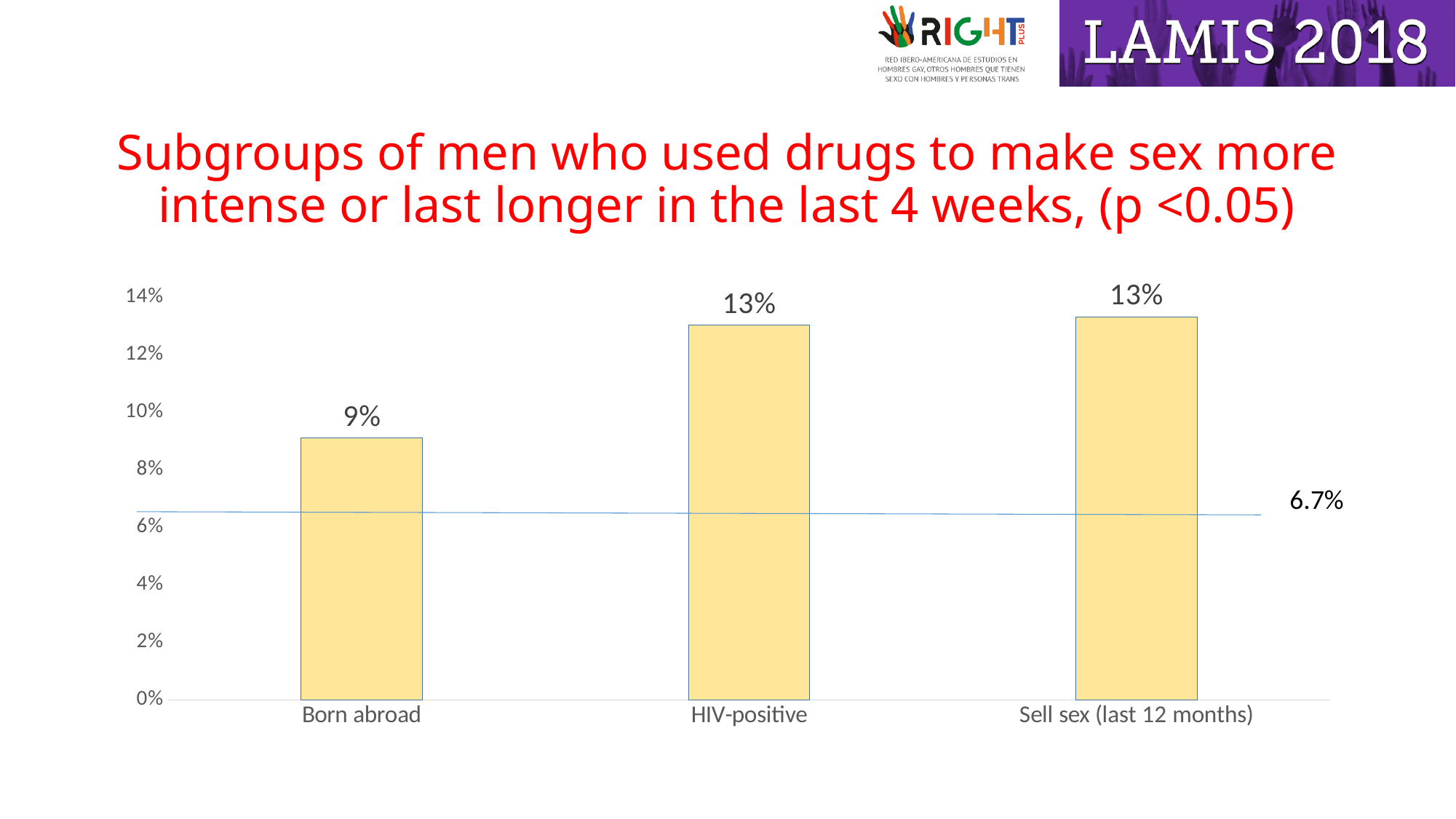
Is the value for Sell sex (last 12 months) greater or less than 12%? greater Is the value for Born abroad greater or less than 8%? greater What is the value for Sell sex (last 12 months)? 13% What kind of chart is shown on the slide? bar chart Which is larger, the value for Born abroad or the value for HIV-positive? HIV-positive What value is labelled on the horizontal reference line across the chart? 6.7% What is the highest value shown on the y axis? 14% What is the difference between the values for HIV-positive and Born abroad? 4% Which category has the lowest value? Born abroad How many categories are shown on the x axis? 3 What is the value for Born abroad? 9% What is the value for HIV-positive? 13%